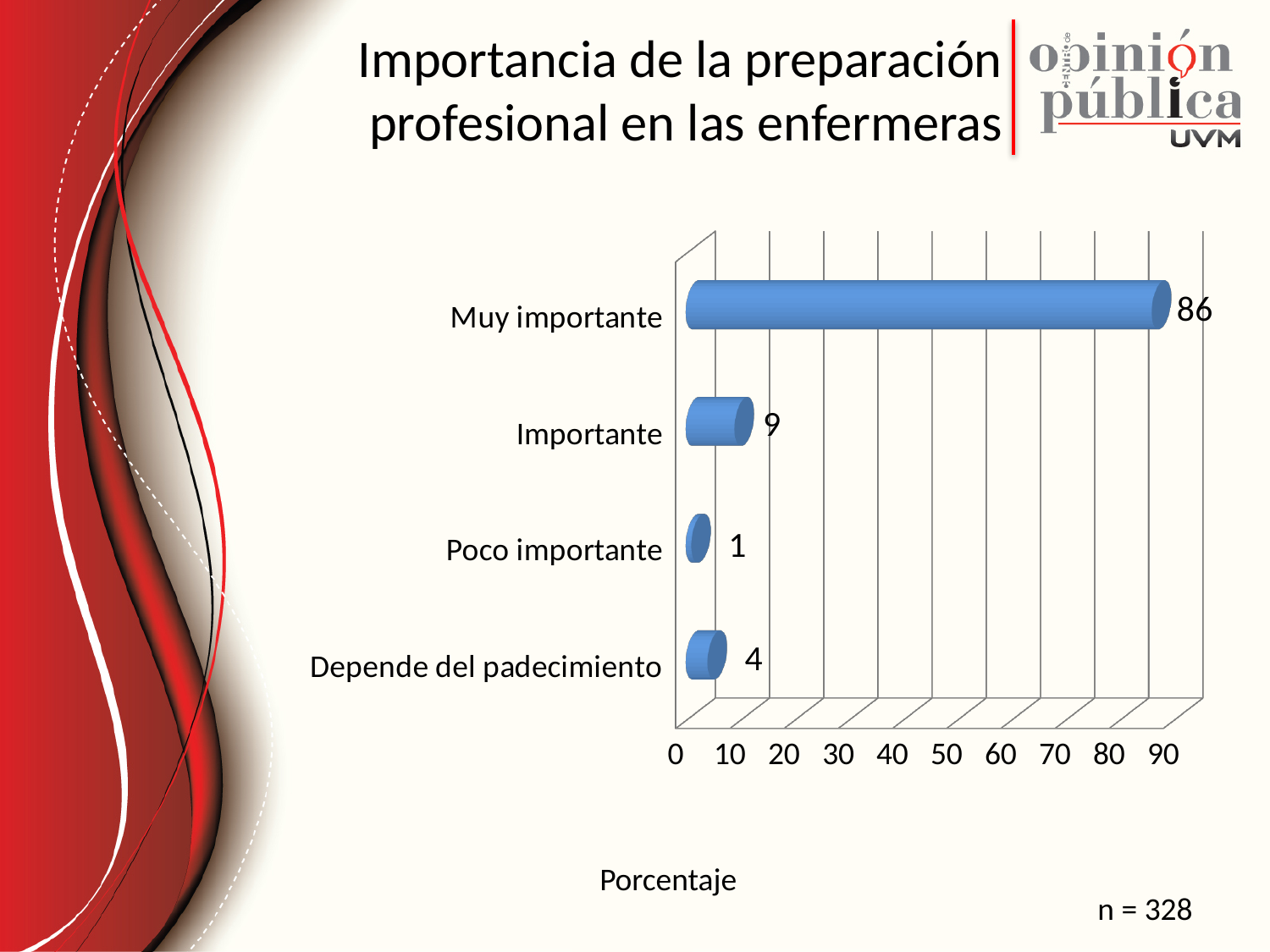
What kind of chart is shown on the slide? Bar chart Which category has the lowest value? Poco importante What is the value for "Importante"? 9 What is the value for "Poco importante"? 1 What is the difference between the values for "Muy importante" and "Importante"? 77 What is the value for "Depende del padecimiento"? 4 Which is larger, the value for "Importante" or the value for "Depende del padecimiento"? Importante How many categories are shown in the chart? 4 Which category has the highest value? Muy importante What is the value for "Muy importante"? 86 What is the difference between the values for "Depende del padecimiento" and "Poco importante"? 3 What is the label of the horizontal axis? Porcentaje